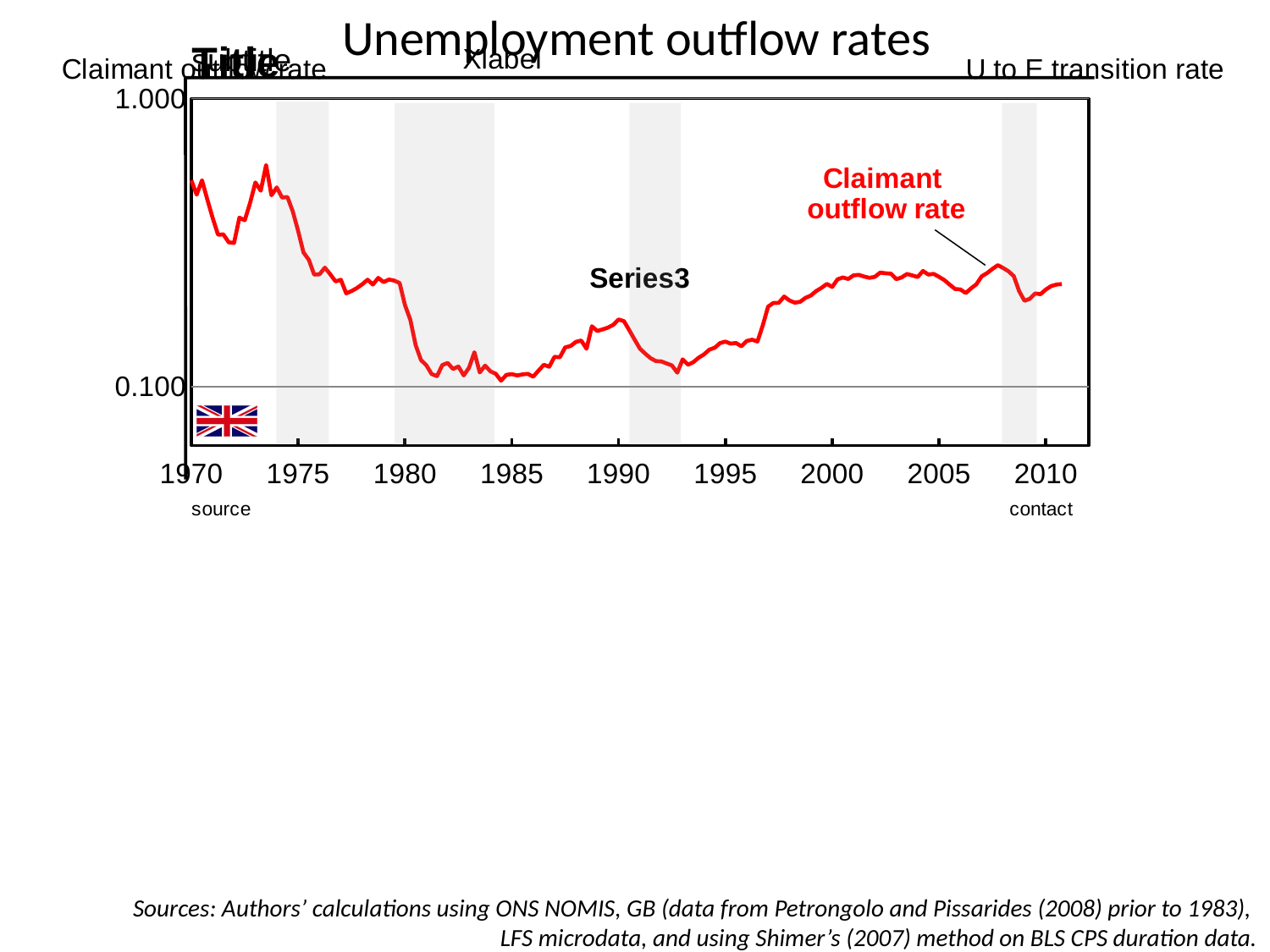
Which is larger, the claimant outflow rate in 1973 or in 1985? 1973 Is the claimant outflow rate in 2000 greater or less than 0.100? greater What is the title of the chart? Unemployment outflow rates Does the claimant outflow rate rise or fall between 1993 and 2003? rise Is the claimant outflow rate in 1973 greater or less than 1.000? less What label is attached to the red line in the chart? Claimant outflow rate How many year labels are shown on the x axis? 9 Does the claimant outflow rate rise or fall between 1975 and 1985? fall What kind of chart is shown on the slide? line chart Is the claimant outflow rate in 1980 greater or less than 0.100? greater Which is larger, the claimant outflow rate in 2008 or in 1985? 2008 What is the first year labelled on the x axis? 1970